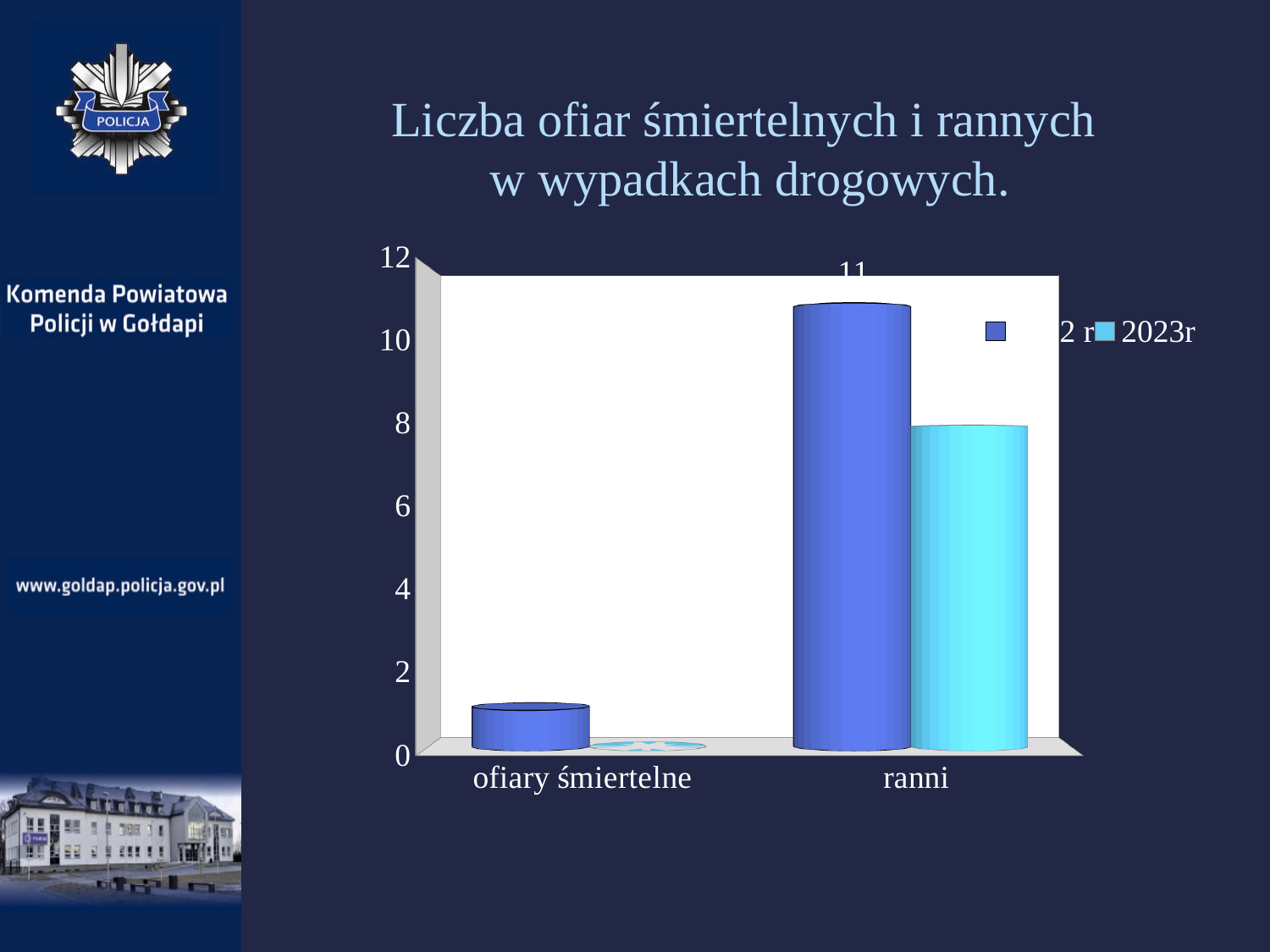
How many series does the chart's legend list? 2 Which legend entry corresponds to the light blue bars? 2023r What kind of chart is shown on the slide? bar chart Is the light blue (2023r) value for 'ranni' greater or less than 6? greater In the light blue (2023r) series, which category has the larger value, 'ofiary śmiertelne' or 'ranni'? ranni What is the value of the dark blue bar for 'ranni'? 11 What is the title of the chart? Liczba ofiar śmiertelnych i rannych w wypadkach drogowych. Is the light blue (2023r) value for 'ranni' greater or less than 10? less Is the dark blue value for 'ofiary śmiertelne' greater or less than 2? less Which category has the taller dark blue bar, 'ofiary śmiertelne' or 'ranni'? ranni How many categories are shown on the x axis of the chart? 2 For 'ranni', which bar is taller, the dark blue one or the light blue (2023r) one? the dark blue one